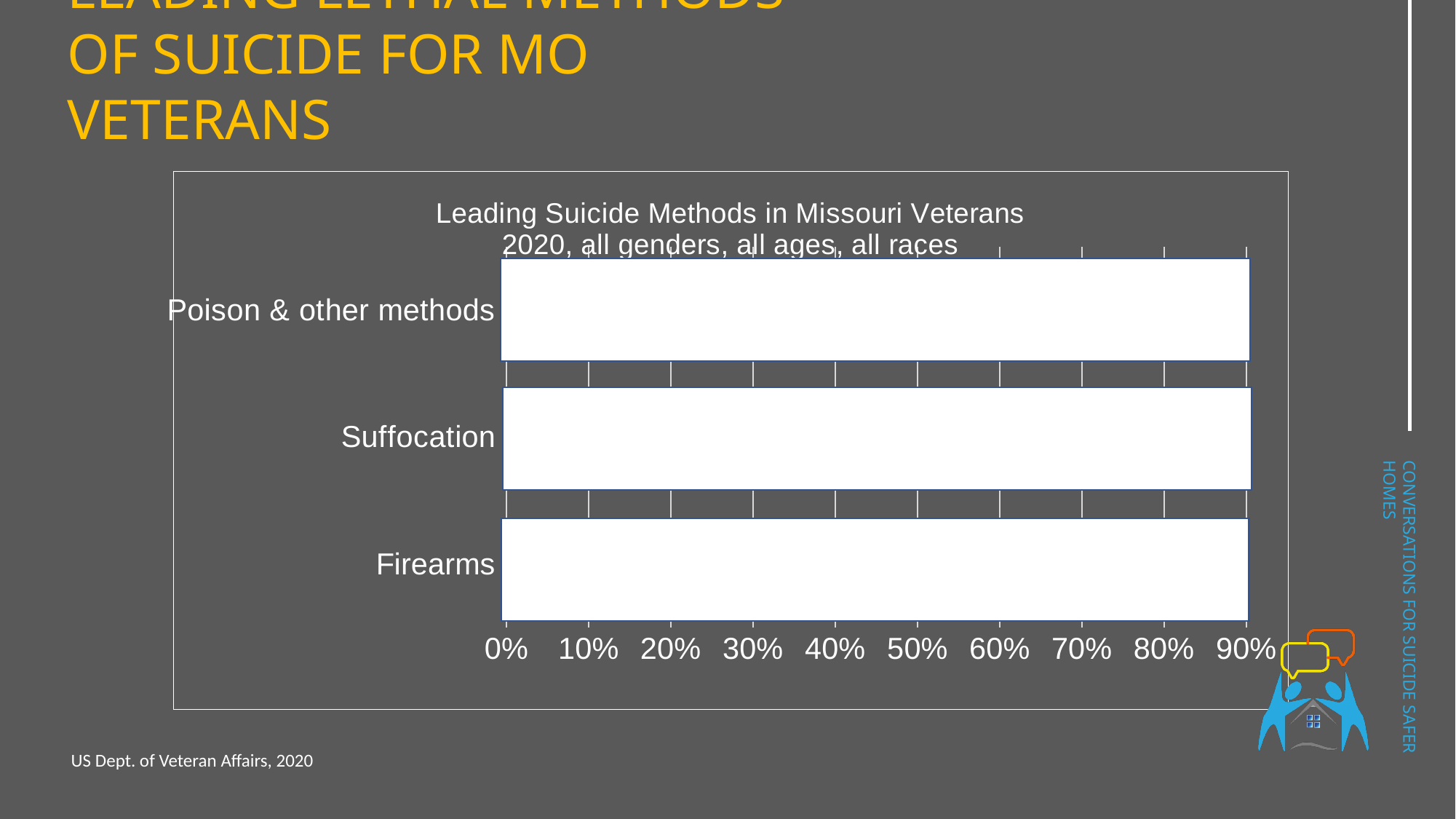
What kind of chart is shown on the slide? bar chart What is the interval between tick labels on the horizontal axis of the chart? 10% What is the highest value shown on the horizontal axis of the chart? 90% What is the title of the chart? Leading Suicide Methods in Missouri Veterans 2020, all genders, all ages, all races How many categories (suicide methods) are plotted in the chart? 3 Is the value for Firearms greater or less than 50%? greater Which category is listed at the bottom of the chart? Firearms What is the lowest value shown on the horizontal axis of the chart? 0%